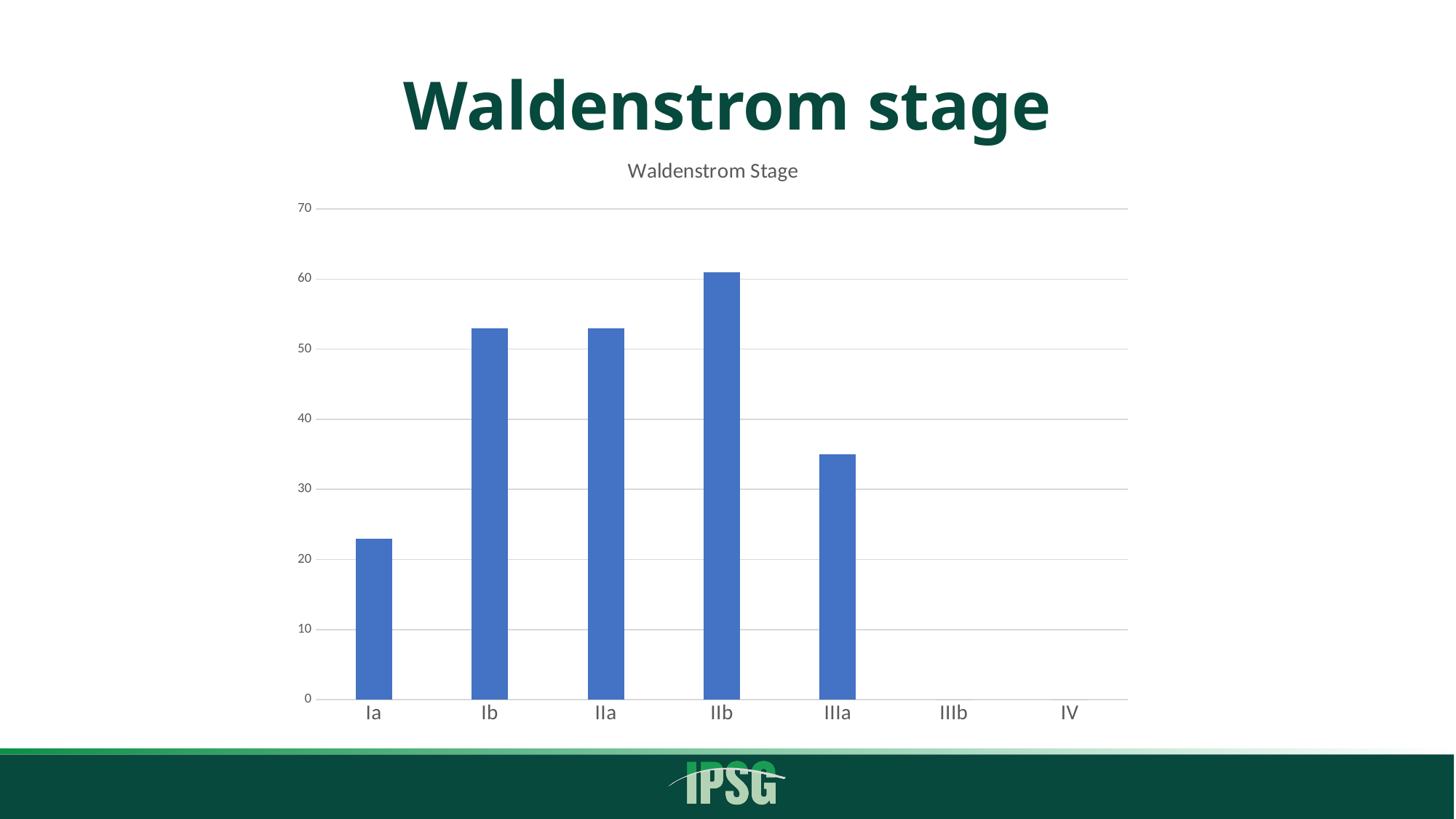
What kind of chart is shown on the slide? bar chart Which is larger, the value for Ia or the value for IIIa? IIIa What is the title printed above the chart's plot area? Waldenstrom Stage Which category has the highest bar in the chart? IIb Is the value for IIIa greater or less than 30? greater Is the value for Ia greater or less than 20? greater How many categories are shown on the x axis of the chart? 7 Which is larger, the value for IIb or the value for IIIa? IIb Is the value for Ib greater or less than 60? less